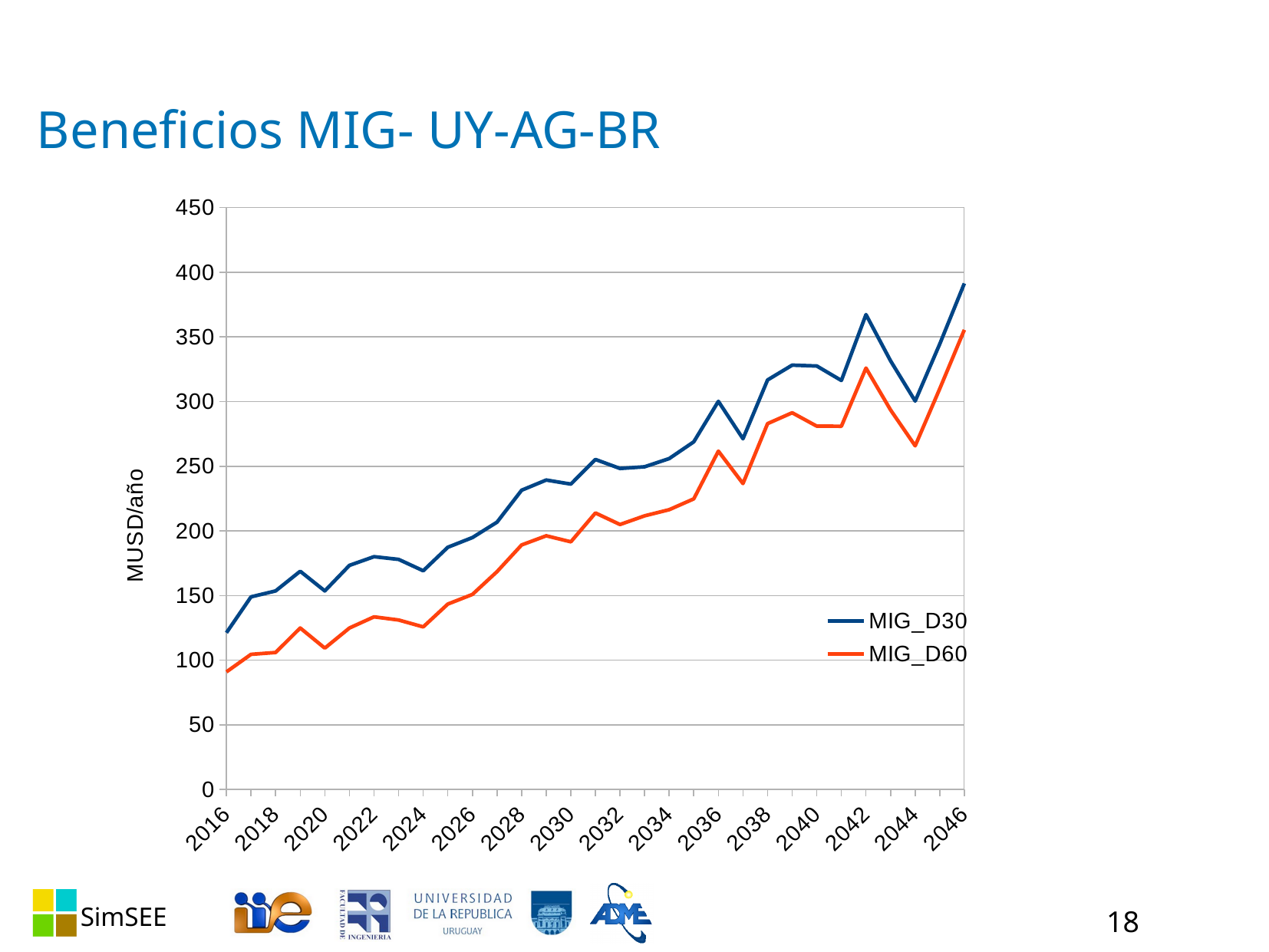
In which year does MIG_D60 have its lowest value? 2016 How many series does the legend list? 2 Do the values of MIG_D30 generally rise or fall from 2016 to 2046? rise What kind of chart is shown on the slide? line chart Is the value for MIG_D30 in 2042 greater or less than 350? greater Which series has the higher values across the whole period, MIG_D30 or MIG_D60? MIG_D30 What are the names of the two series in the legend? MIG_D30 and MIG_D60 What is the label of the vertical axis? MUSD/año Is the value for MIG_D60 in 2016 greater or less than 100? less In which year does MIG_D30 reach its highest value? 2046 Is the value for MIG_D60 in 2044 greater or less than 250? greater